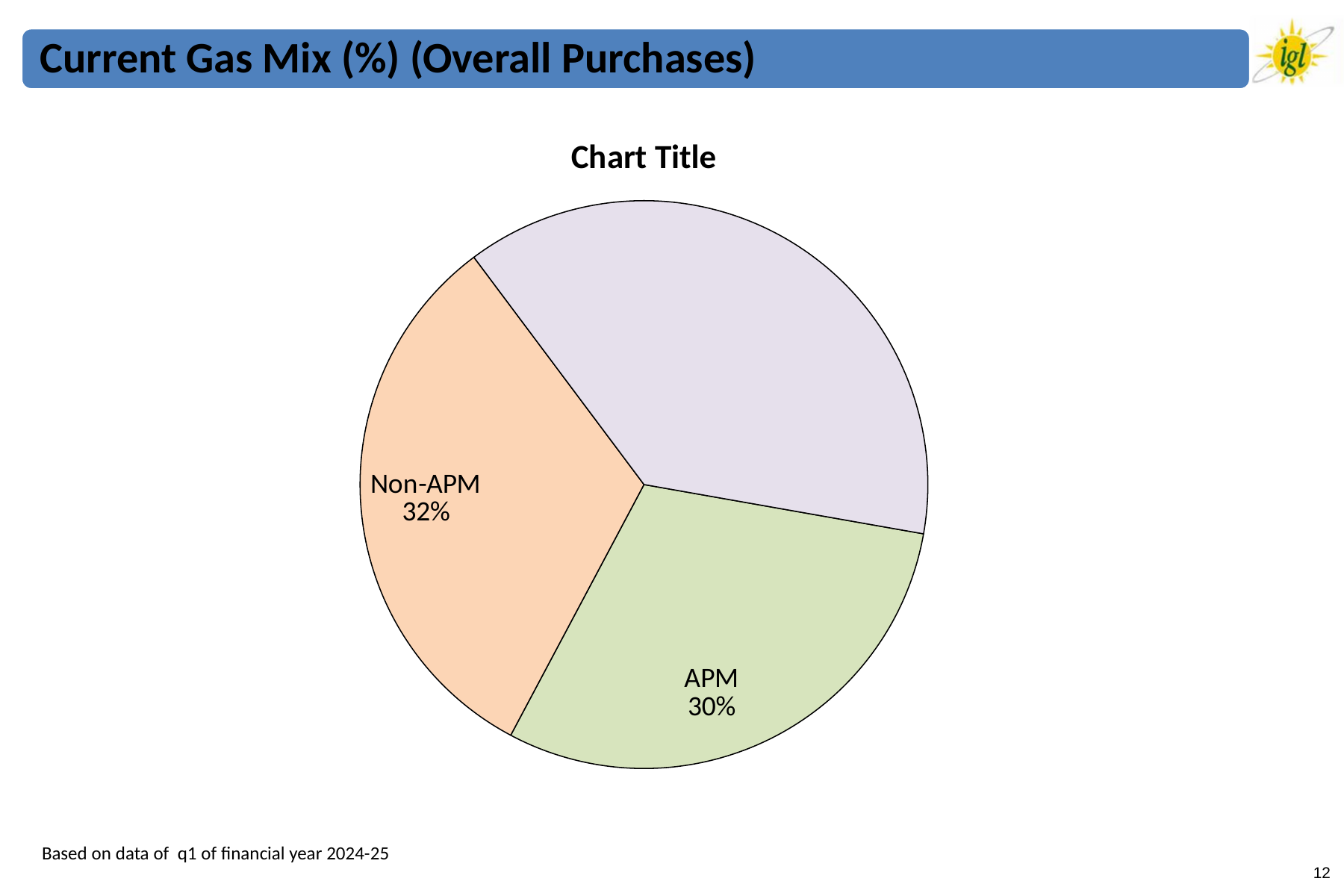
Is the value for APM greater or less than 50%? less What is the difference in percentage points between the Non-APM and APM slices? 2 percentage points What kind of chart is shown on the slide? Pie chart What is the value shown for Non-APM? 32% What is the value shown for APM? 30% What is the title printed above the pie chart? Chart Title What colour is the APM slice of the pie chart? Green What share of the pie does the APM slice represent? 30% Which is larger, the Non-APM slice or the APM slice? Non-APM What share of the pie does the Non-APM slice represent? 32% How many slices does the pie chart have? 3